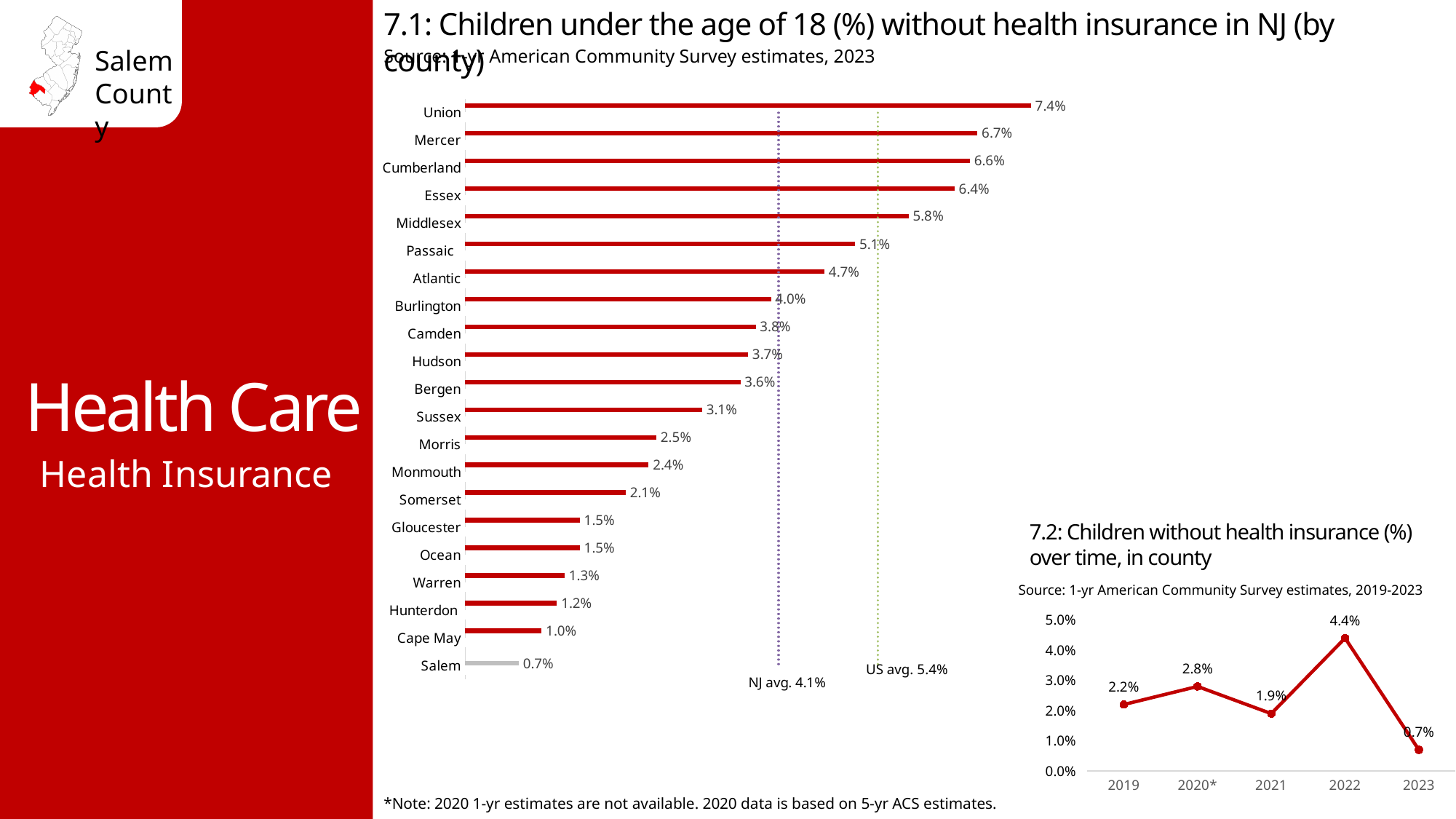
In chart 7.2 (children without health insurance over time in county), what is the value for 2022? 4.4% In chart 7.1, which county has the highest percentage of children without health insurance? Union In chart 7.1, which county has the lowest percentage of children without health insurance? Salem In chart 7.1 (children under 18 without health insurance by county), what is the value for Cumberland? 6.6% In chart 7.1, what is the NJ average shown by the dotted reference line? 4.1% In chart 7.1, how many counties are shown? 21 In chart 7.1, what is the difference between the values for Union and Salem? 6.7 percentage points What type of chart is chart 7.2? Line chart In chart 7.1, which county has a higher value, Passaic or Atlantic? Passaic In chart 7.2, what is the difference between the 2022 and 2023 values? 3.7 percentage points What type of chart is chart 7.1? Bar chart In chart 7.2, which year has the lowest value? 2023